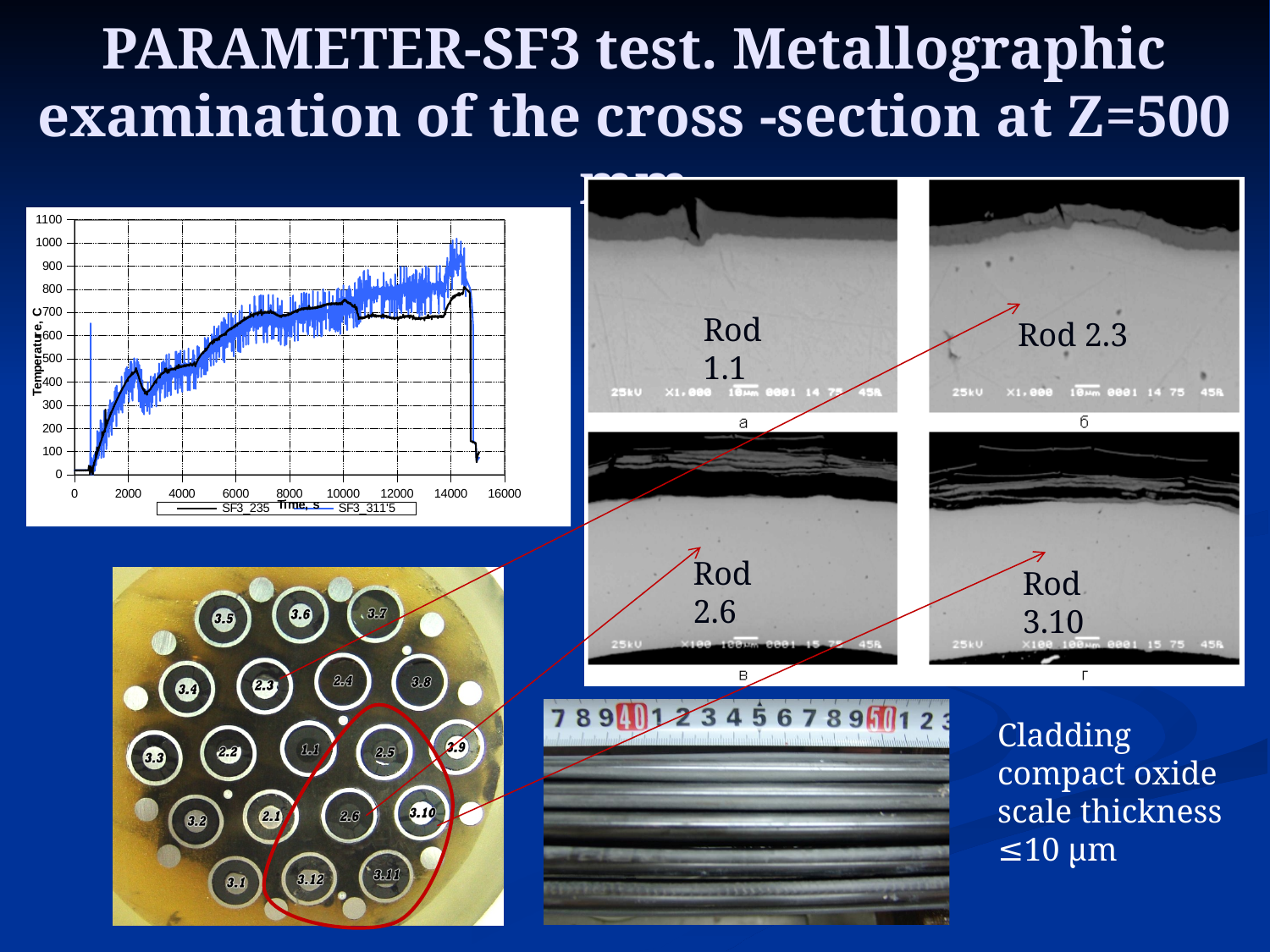
Which series reaches the higher peak temperature, SF3_235 or SF3_311'5? SF3_311'5 What is the highest tick value shown on the vertical axis of the temperature chart? 1100 Is the peak temperature of the SF3_311'5 series greater or less than 900? greater What kind of chart is shown on the left of the slide? line chart What are the two series named in the legend of the temperature chart? SF3_235 and SF3_311'5 How many series does the legend of the temperature chart list? 2 Is the SF3_235 temperature at time 6000 s greater or less than 500? greater Is the SF3_235 temperature at time 10000 s greater or less than 500? greater What is the label of the vertical axis of the temperature chart? Temperature, C Does the temperature generally rise or fall between 0 and 14000 s in the temperature chart? rise What is the highest tick value shown on the horizontal axis (Time, s) of the temperature chart? 16000